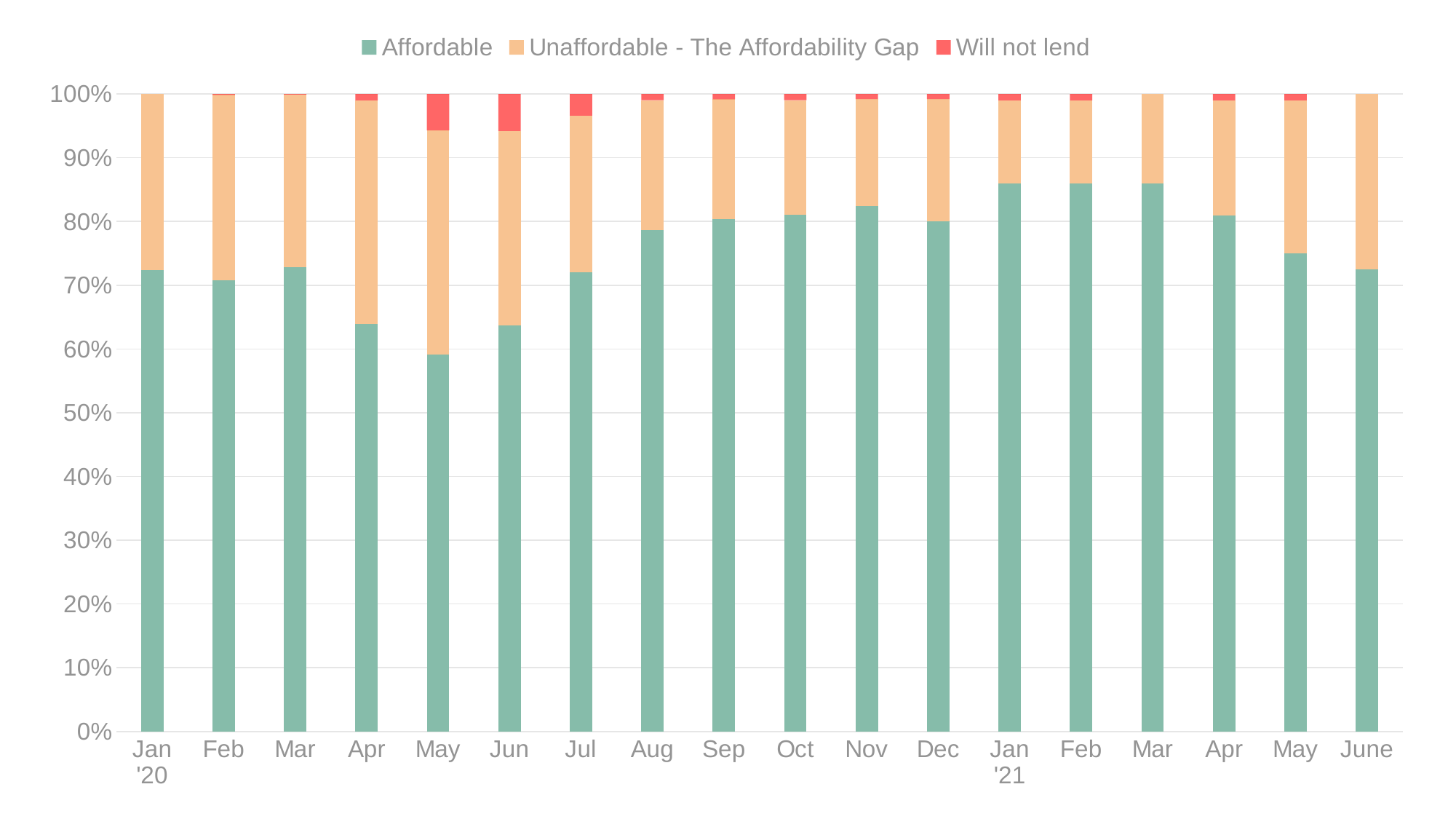
Is the Affordable value for Apr '20 greater or less than 70%? less How many series does the legend list? 3 Does the Affordable share rise or fall from May '20 to Jan '21? rise Is the Affordable value for Nov '20 greater or less than 80%? greater What kind of chart is shown on the slide? Stacked bar chart Is the Affordable value for May '20 greater or less than 70%? less Which has the larger Affordable share, Jan '21 or May '21? Jan '21 Which legend entry is shown in red? Will not lend Which month has the lowest Affordable share? May '20 Which has the larger Affordable share, Sep '20 or Apr '20? Sep '20 How many months are plotted along the x axis? 18